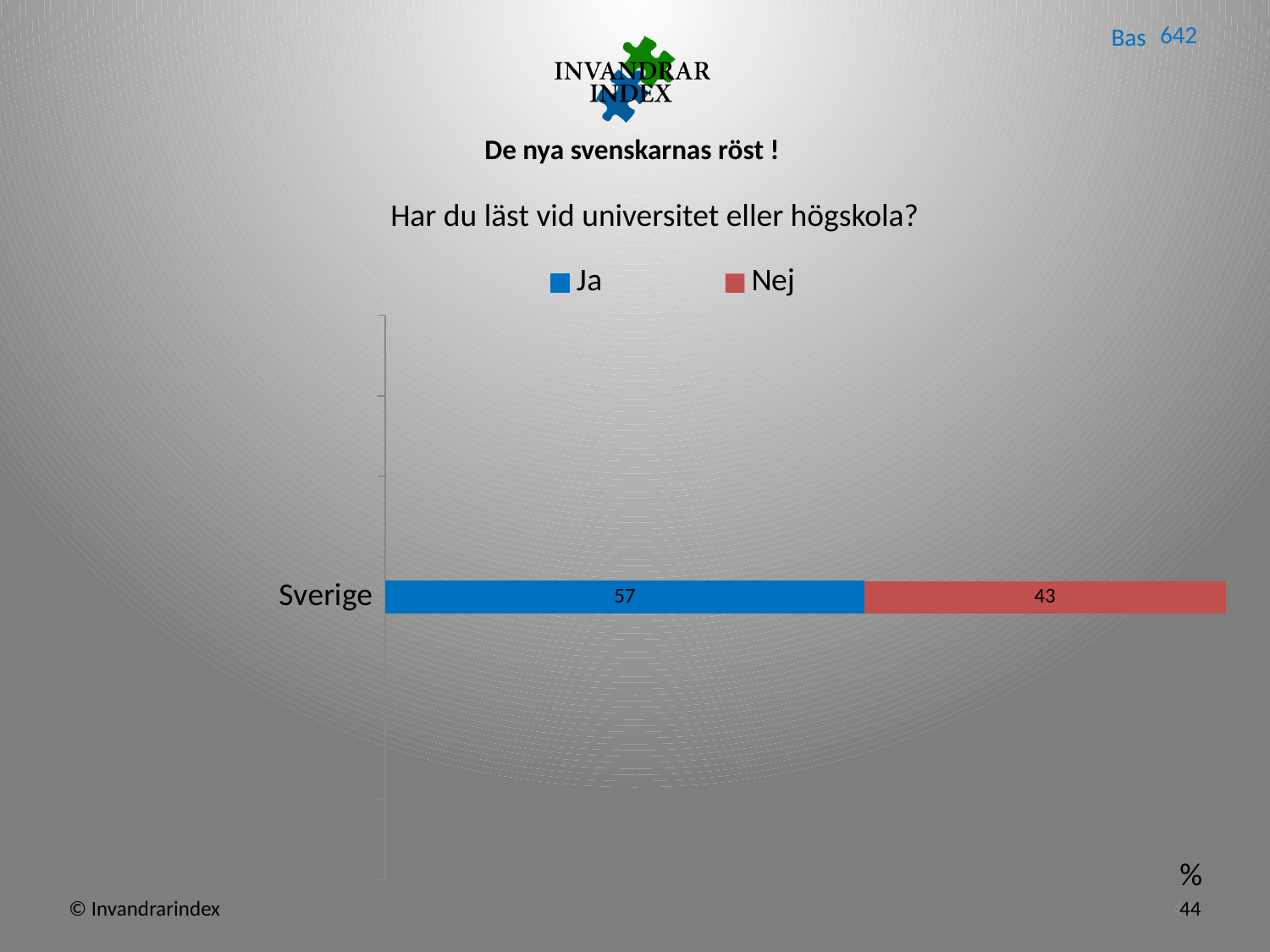
What is the name of the only category on the chart? Sverige What is the value for Ja for Sverige? 57 Which colour represents Nej in the legend? Red What is the difference between the Ja and Nej values for Sverige? 14 Which series has the larger value for Sverige, Ja or Nej? Ja How many categories are plotted on the chart? 1 What is the total of the stacked bar for Sverige? 100 How many series does the legend list? 2 What question is the chart titled with? Har du läst vid universitet eller högskola? What is the value for Nej for Sverige? 43 What kind of chart is shown on the slide? Stacked bar chart